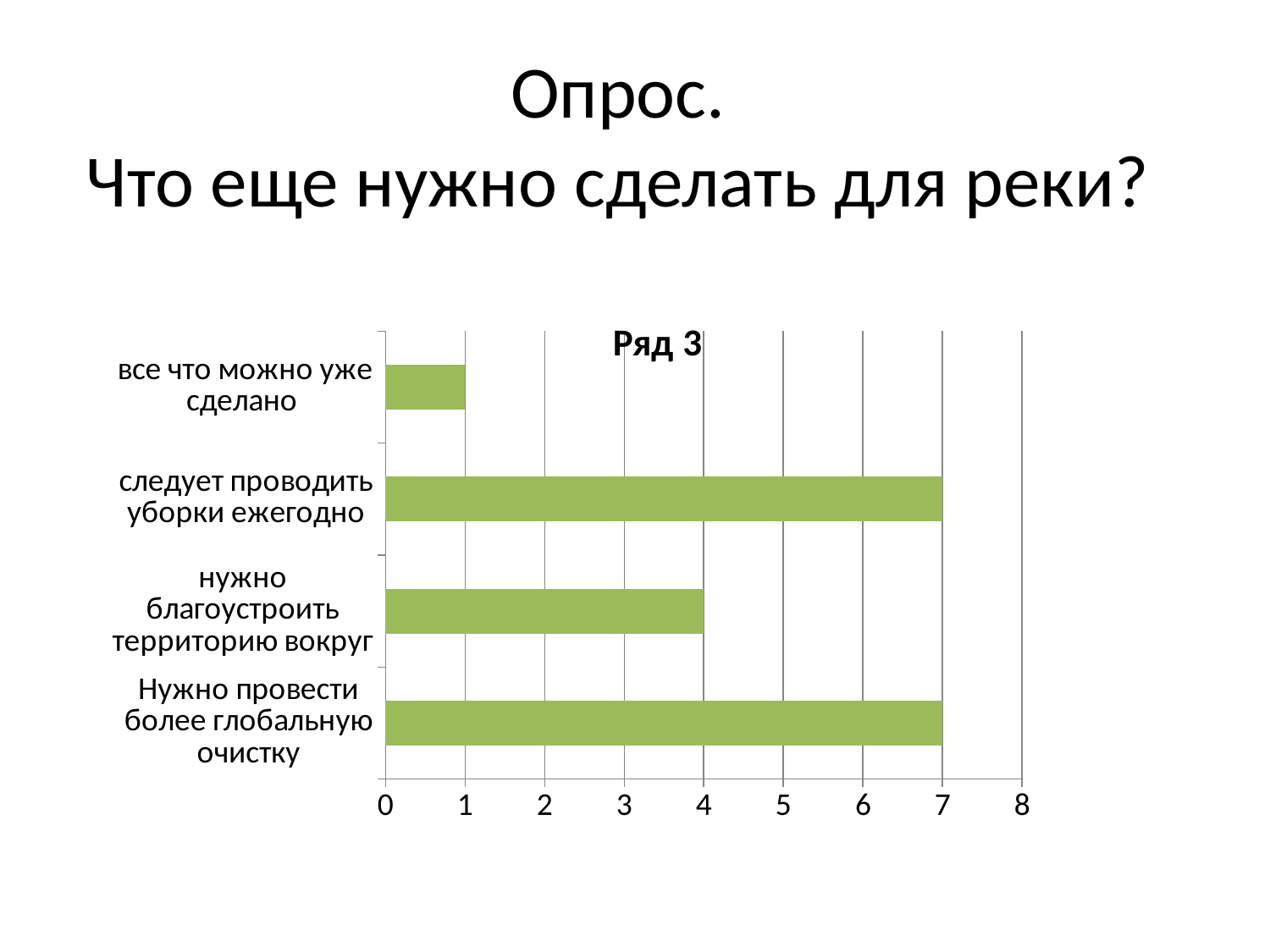
Which category has the lowest value? все что можно уже сделано What is the value for "все что можно уже сделано"? 1 How many categories are shown in the chart? 4 What is the title of the chart? Ряд 3 Which is larger: the value for "нужно благоустроить территорию вокруг" or the value for "Нужно провести более глобальную очистку"? Нужно провести более глобальную очистку What is the difference between the values for "Нужно провести более глобальную очистку" and "все что можно уже сделано"? 6 What is the value for "следует проводить уборки ежегодно"? 7 What is the value for "нужно благоустроить территорию вокруг"? 4 What kind of chart is shown on the slide? bar chart What is the difference between the values for "следует проводить уборки ежегодно" and "нужно благоустроить территорию вокруг"? 3 What is the value for "Нужно провести более глобальную очистку"? 7 Is the value for "нужно благоустроить территорию вокруг" greater or less than 5? less